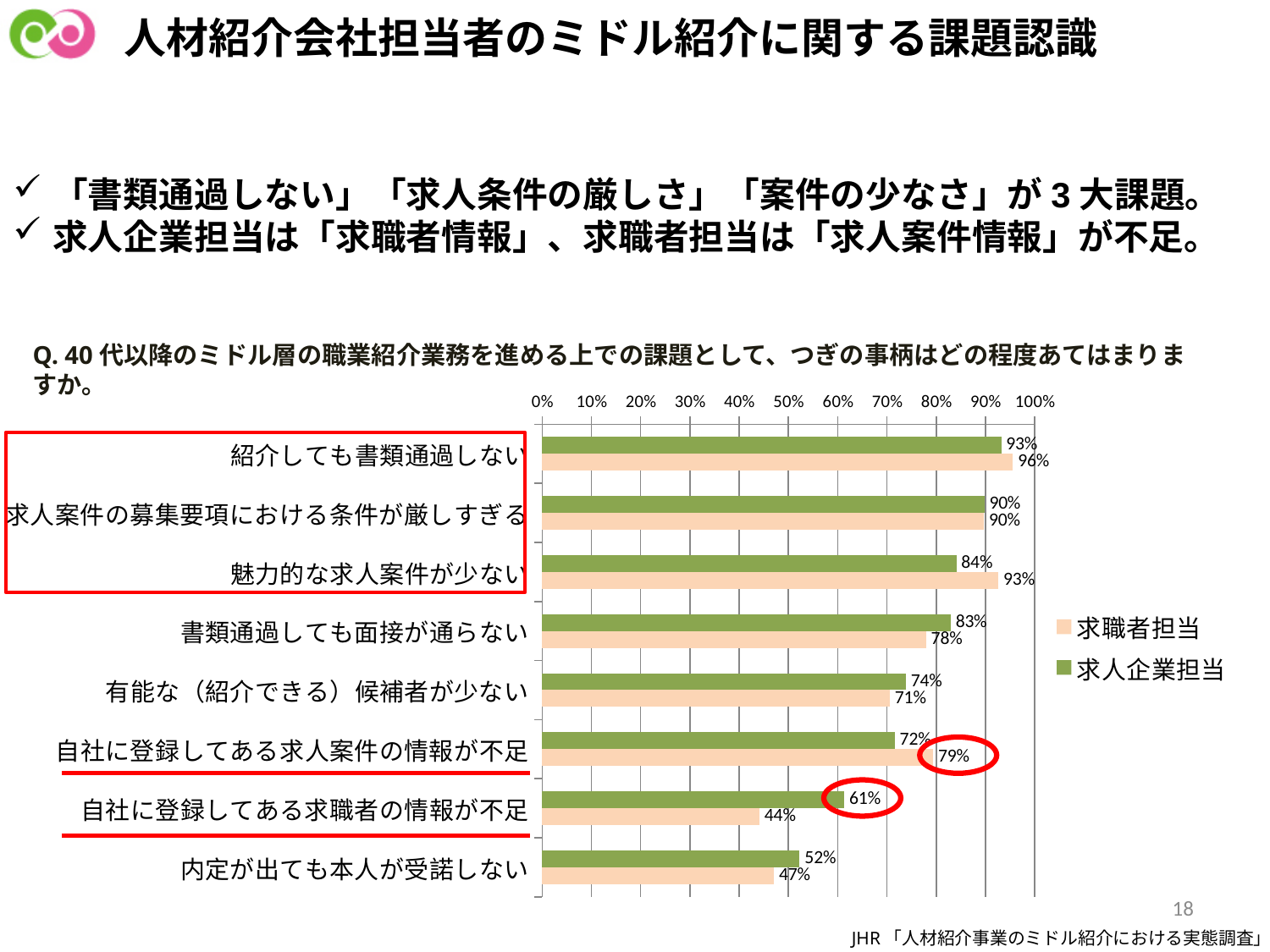
「自社に登録してある求職者の情報が不足」の求人企業担当の値はいくつですか？ 61% 凡例に示されている系列はいくつありますか？ 2 「書類通過しても面接が通らない」では、求職者担当と求人企業担当のどちらの値が大きいですか？ 求人企業担当 求人企業担当の系列で最も値が高い項目はどれですか？ 紹介しても書類通過しない 凡例で緑色の棒はどの系列を表していますか？ 求人企業担当 このグラフには項目（カテゴリ）がいくつありますか？ 8 「魅力的な求人案件が少ない」では、求職者担当と求人企業担当のどちらの値が大きいですか？ 求職者担当 これはどの種類のグラフですか？ 棒グラフ 「自社に登録してある求職者の情報が不足」における求人企業担当と求職者担当の値の差はいくつですか？ 17% 「内定が出ても本人が受諾しない」の求職者担当の値はいくつですか？ 47% 求職者担当の系列で最も値が低い項目はどれですか？ 自社に登録してある求職者の情報が不足 「紹介しても書類通過しない」の求職者担当の値はいくつですか？ 96%